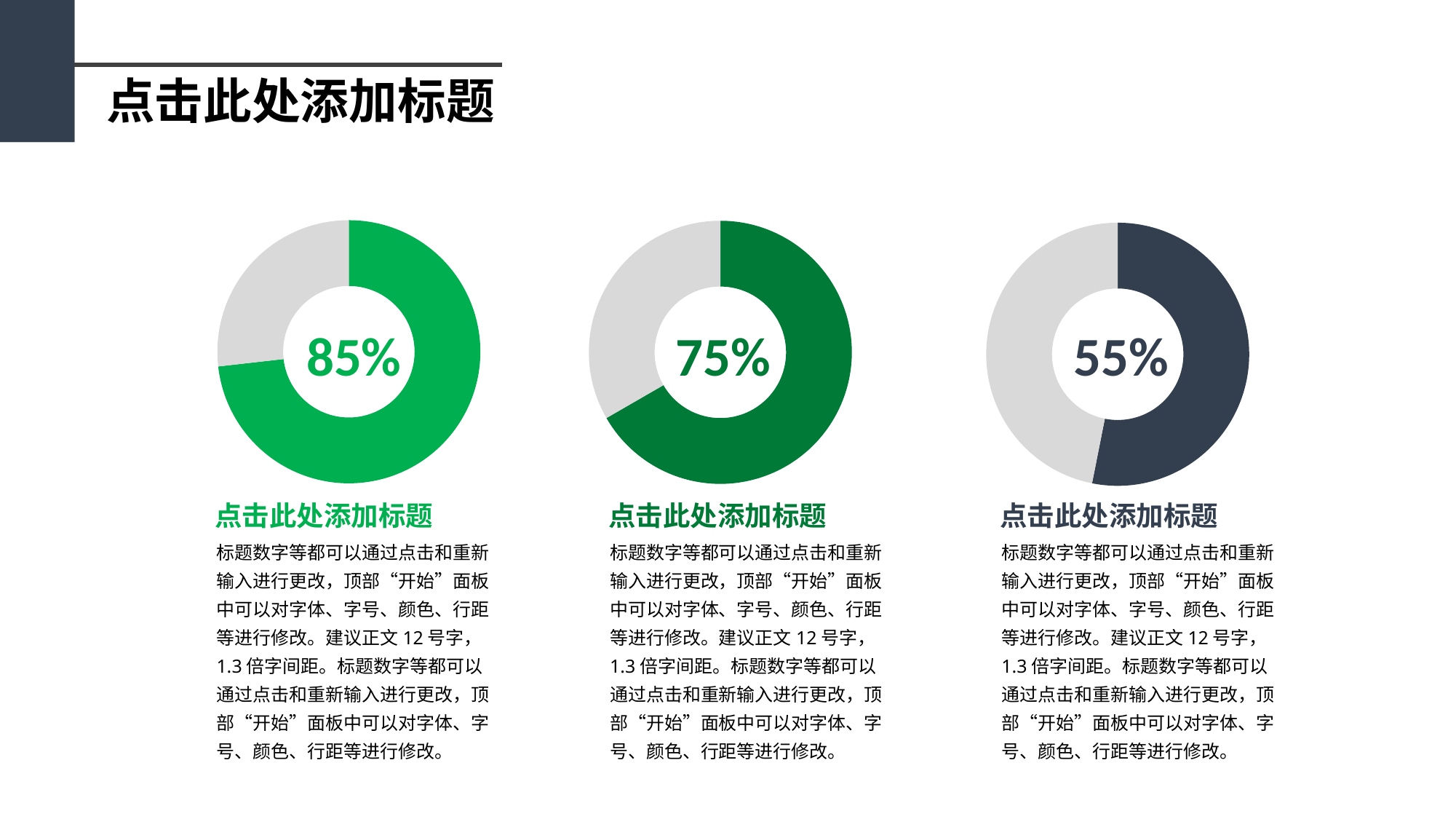
What value is shown in the centre of the right donut chart? 55% Is the percentage in the middle donut chart larger or smaller than the percentage in the right donut chart? larger Which of the three donut charts shows the highest percentage: left, middle or right? left Which of the three donut charts shows the lowest percentage: left, middle or right? right How many donut charts are on the slide? 3 What colour is the filled segment of the right donut chart? dark navy What is the difference between the percentage in the left donut chart and the percentage in the right donut chart? 30% What is the difference between the percentage in the left donut chart and the percentage in the middle donut chart? 10% What value is shown in the centre of the left donut chart? 85% What value is shown in the centre of the middle donut chart? 75% What kind of chart is used three times on this slide? donut chart